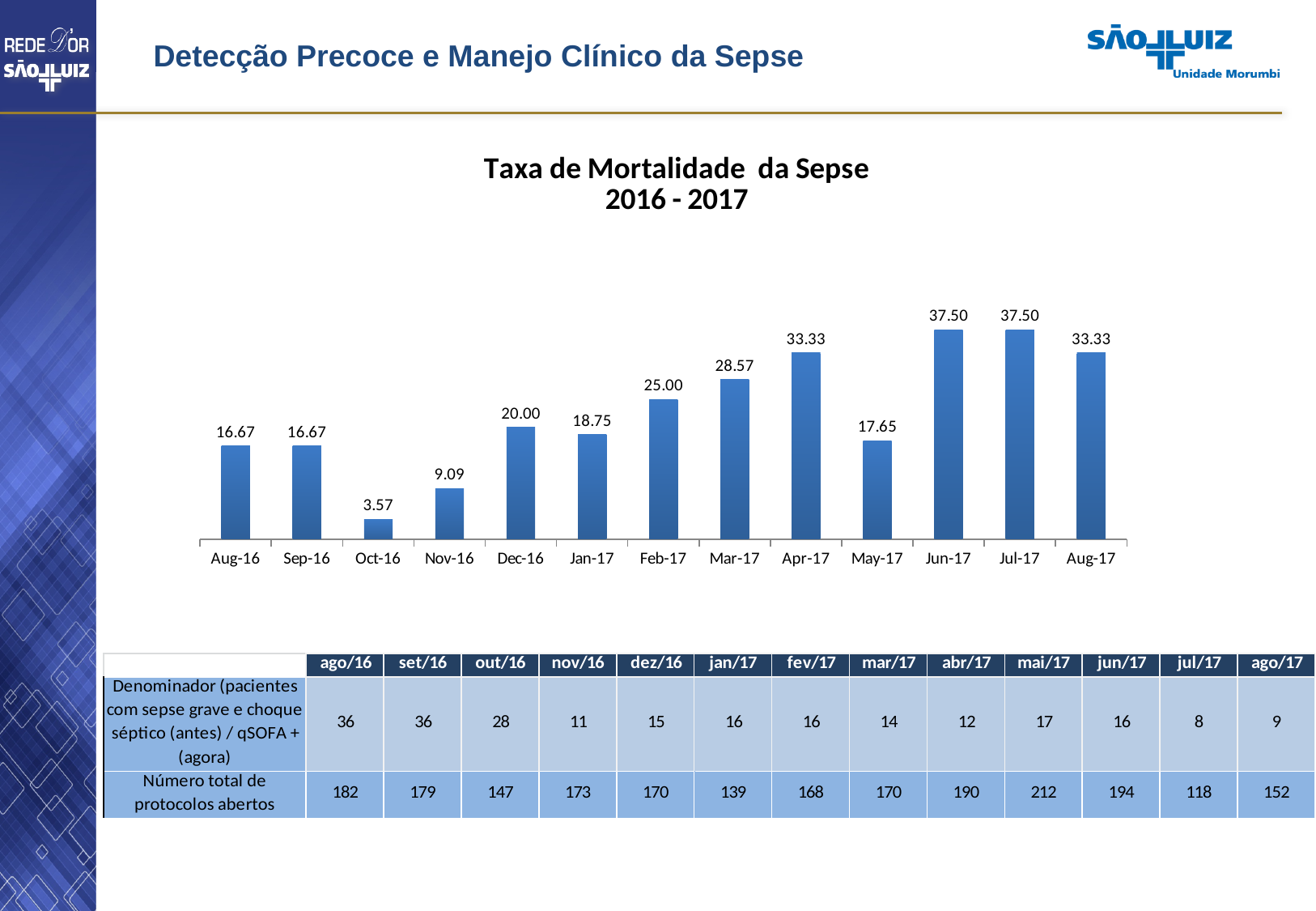
Which month has the lowest value in the chart? Oct-16 What kind of chart is shown on the slide? Bar chart What is the value for May-17 in the chart? 17.65 What is the difference between the values for Jun-17 and May-17? 19.85 What is the highest value shown in the chart? 37.50 What is the difference between the values for Feb-17 and Jan-17? 6.25 What is the value for Oct-16 in the chart? 3.57 Do the values generally rise or fall from Oct-16 to Apr-17? Rise Which is larger, the value for Dec-16 or the value for Jan-17? Dec-16 How many months are plotted in the chart? 13 What is the value for Mar-17 in the chart? 28.57 What is the title of the chart? Taxa de Mortalidade da Sepse 2016 - 2017